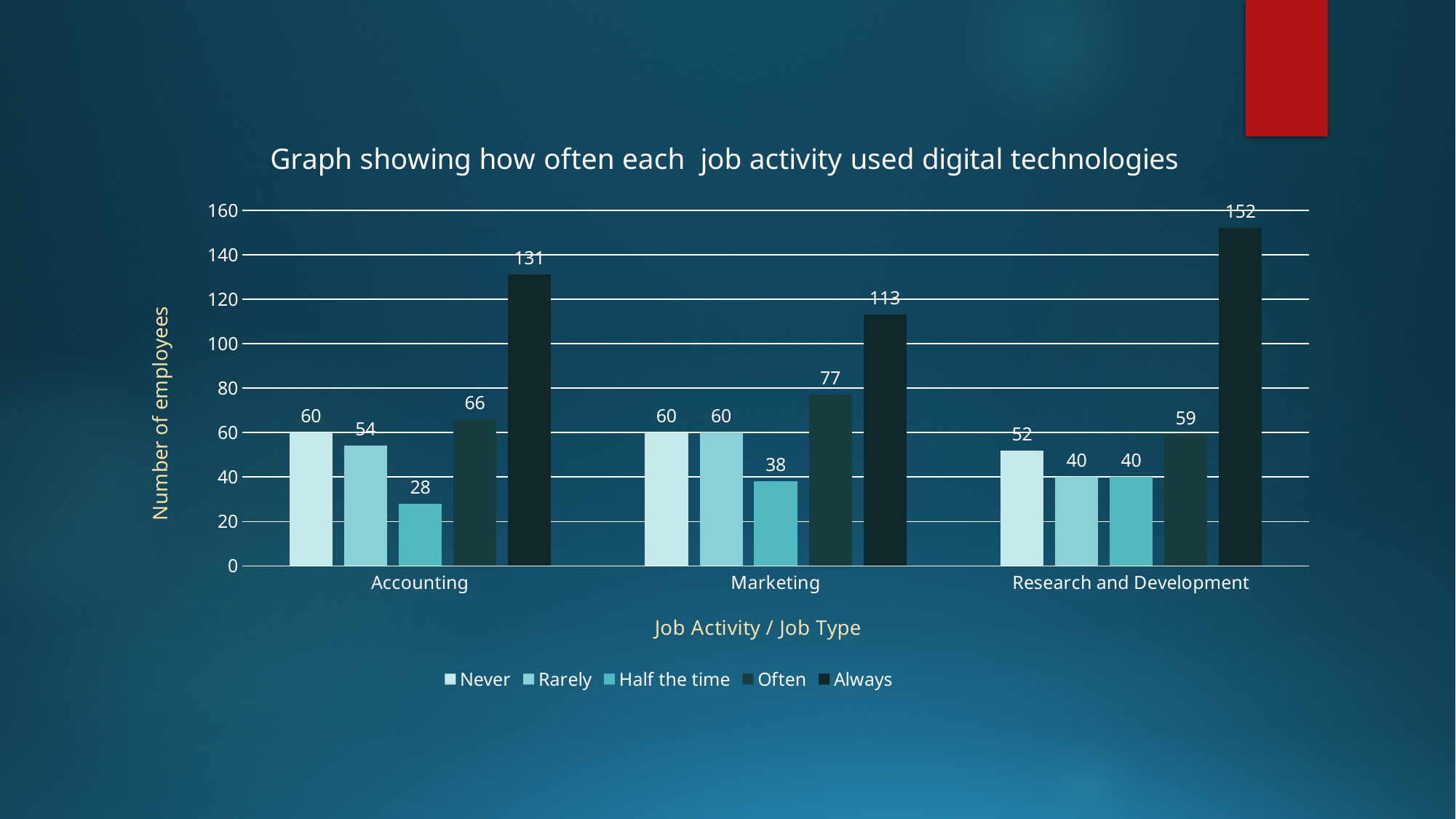
How many job activities are shown on the x axis? 3 Is the value for Always in Marketing greater or less than 100? greater What is the value for Often in Marketing? 77 What kind of chart is shown on the slide? Bar chart How many series does the legend list? 5 What is the value for Always in Research and Development? 152 What is the label of the y axis? Number of employees Which job activity has the highest value for Always? Research and Development What is the value for Half the time in Accounting? 28 Which series has the lowest value in Accounting? Half the time What is the difference between the Always values for Research and Development and Accounting? 21 Which is larger, the Often value for Accounting or the Often value for Marketing? Marketing